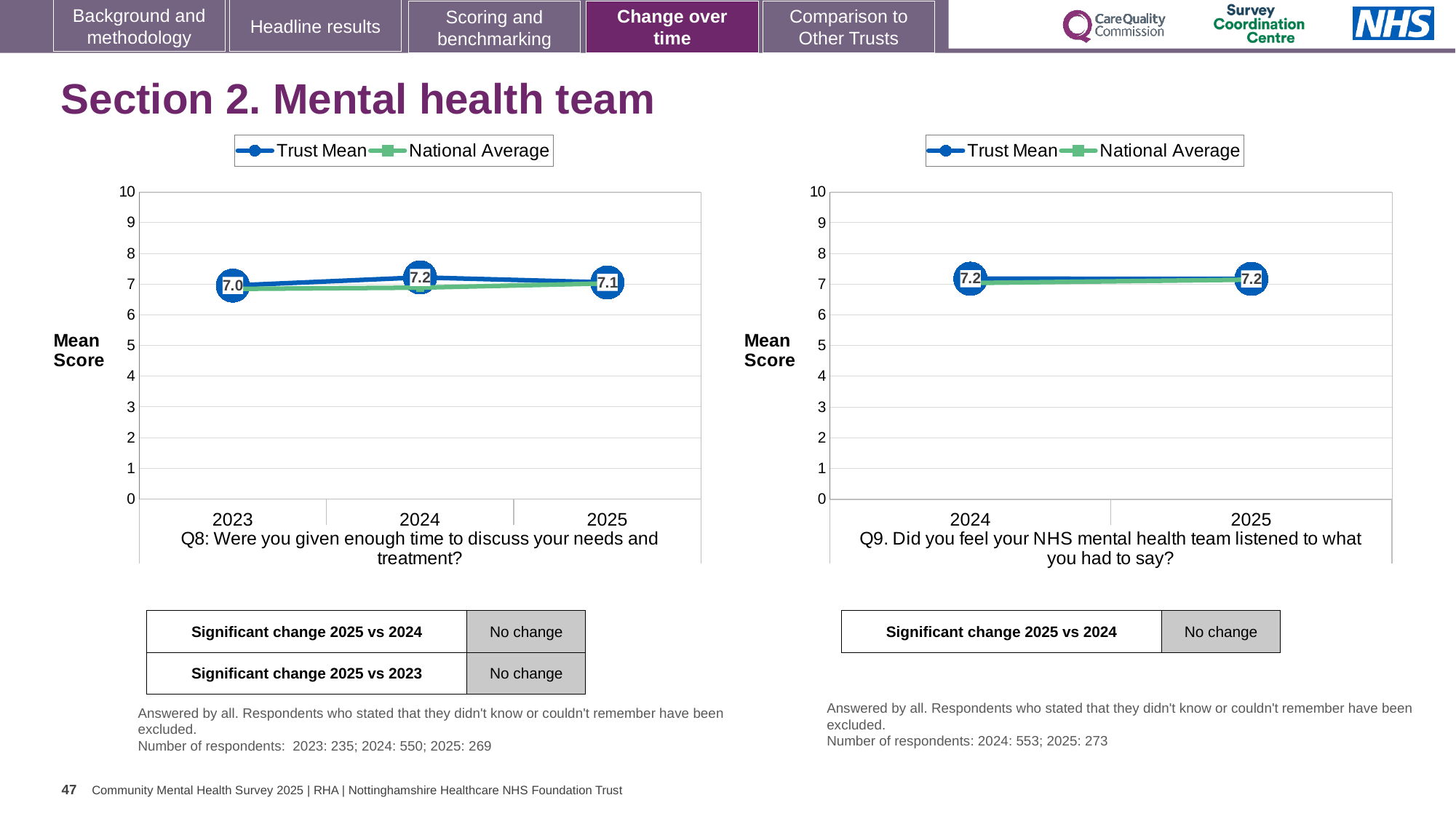
In the left chart (Q8), which year has the highest Trust Mean? 2024 In the left chart (Q8), what is the difference between the Trust Mean for 2024 and 2023? 0.2 In the left chart (Q8), which year has the lowest Trust Mean? 2023 In the right chart (Q9), is the National Average for 2024 greater or less than 8? less In the left chart (Q8), is the Trust Mean higher in 2024 or 2025? 2024 What type of chart is used for Q8 on the left? Line chart How many series does the legend of the right chart (Q9) list? 2 In the left chart (Q8), what is the Trust Mean for 2024? 7.2 In the left chart (Q8), what is the Trust Mean for 2023? 7.0 In the right chart (Q9), what is the Trust Mean for 2025? 7.2 How many years are plotted on the x axis of the left chart (Q8)? 3 What is the label on the vertical axis of the left chart (Q8)? Mean Score